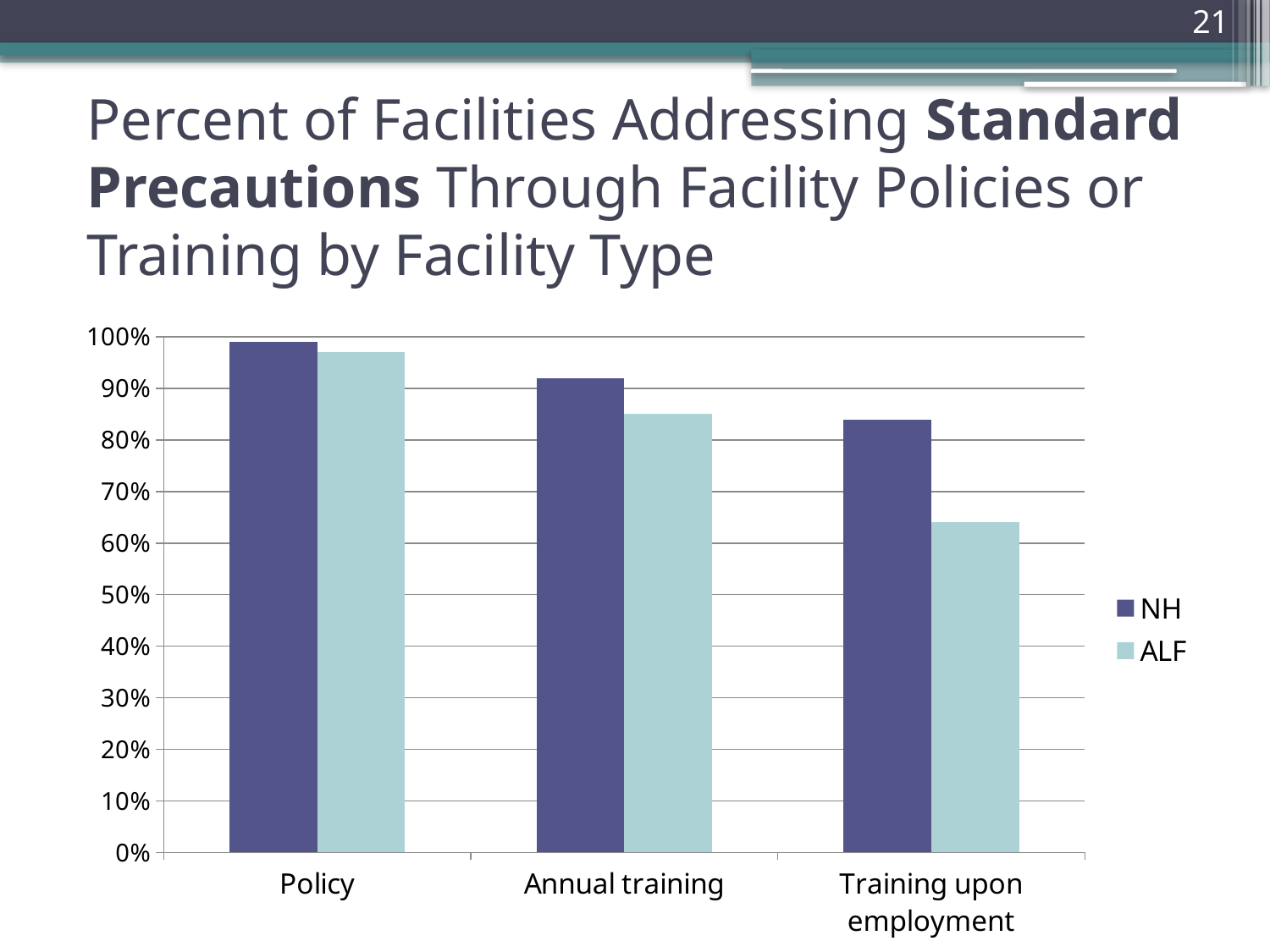
Is the ALF value for Policy greater or less than 90%? greater For Annual training, which series has the larger value, NH or ALF? NH Is the ALF value for Training upon employment greater or less than 70%? less What are the two series named in the legend? NH and ALF How many categories are shown on the x axis of the chart? 3 How many series does the chart's legend list? 2 For which category is the NH value highest? Policy What kind of chart is shown on the slide? bar chart Is the NH value for Annual training greater or less than 80%? greater For Training upon employment, which series has the larger value, NH or ALF? NH For which category is the ALF value lowest? Training upon employment Do the NH values rise or fall moving from Policy to Training upon employment along the x axis? fall